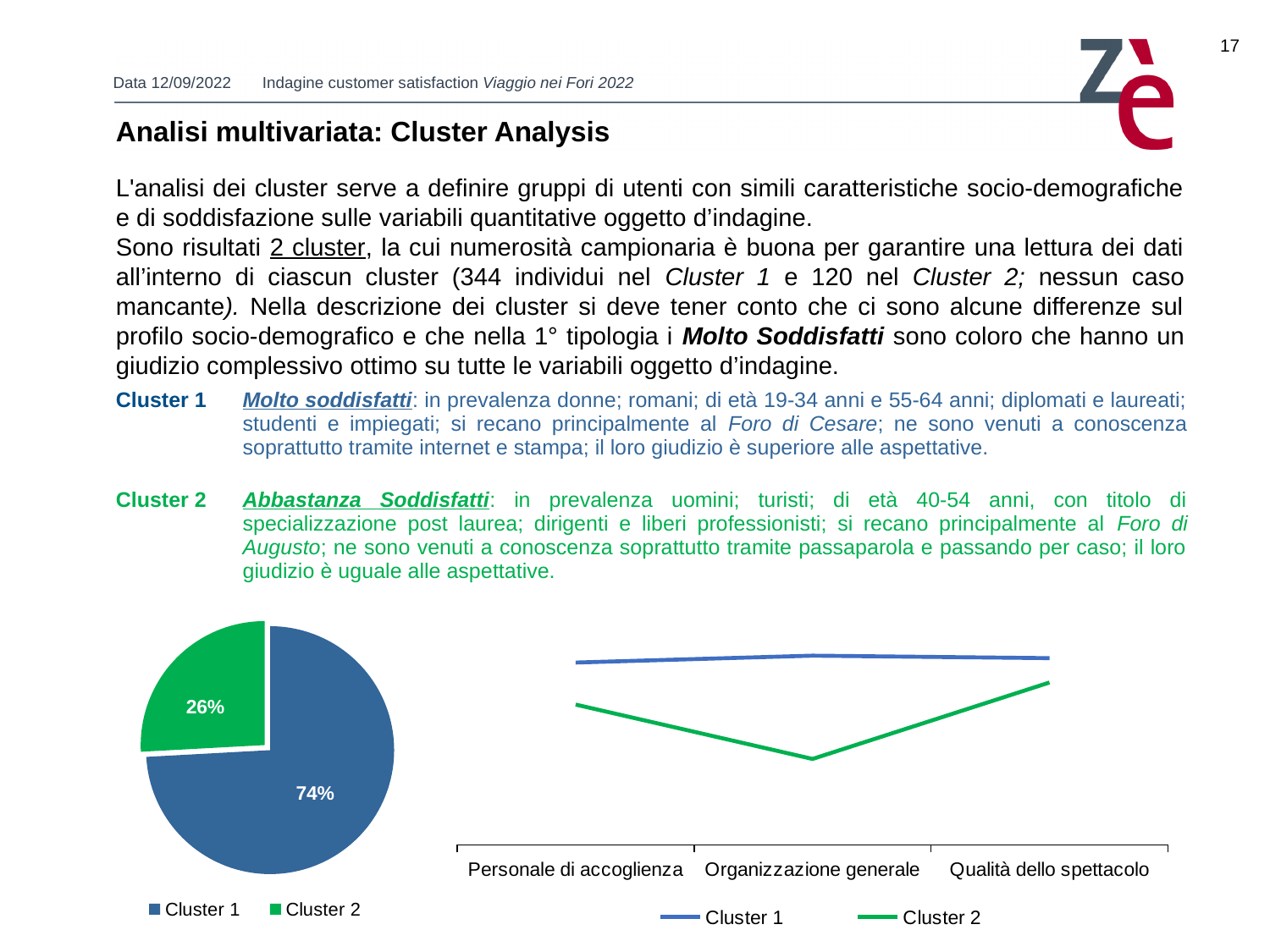
In the pie chart on the left, what percentage is shown for Cluster 1? 74% In the pie chart on the left, what percentage is shown for Cluster 2? 26% How many series does the legend of the line chart on the right list? 2 How many slices does the pie chart on the left have? 2 In the pie chart on the left, which cluster has the larger slice? Cluster 1 What kind of chart is the chart on the right of the slide? Line chart How many categories are shown on the x axis of the line chart on the right? 3 What kind of chart is the chart on the left of the slide? Pie chart In the line chart on the right, which series has the higher value for Organizzazione generale, Cluster 1 or Cluster 2? Cluster 1 In the pie chart on the left, which cluster has the smaller slice? Cluster 2 In the pie chart on the left, what is the difference in percentage points between Cluster 1 and Cluster 2? 48 percentage points In the line chart on the right, at which category does the Cluster 2 line reach its lowest point? Organizzazione generale